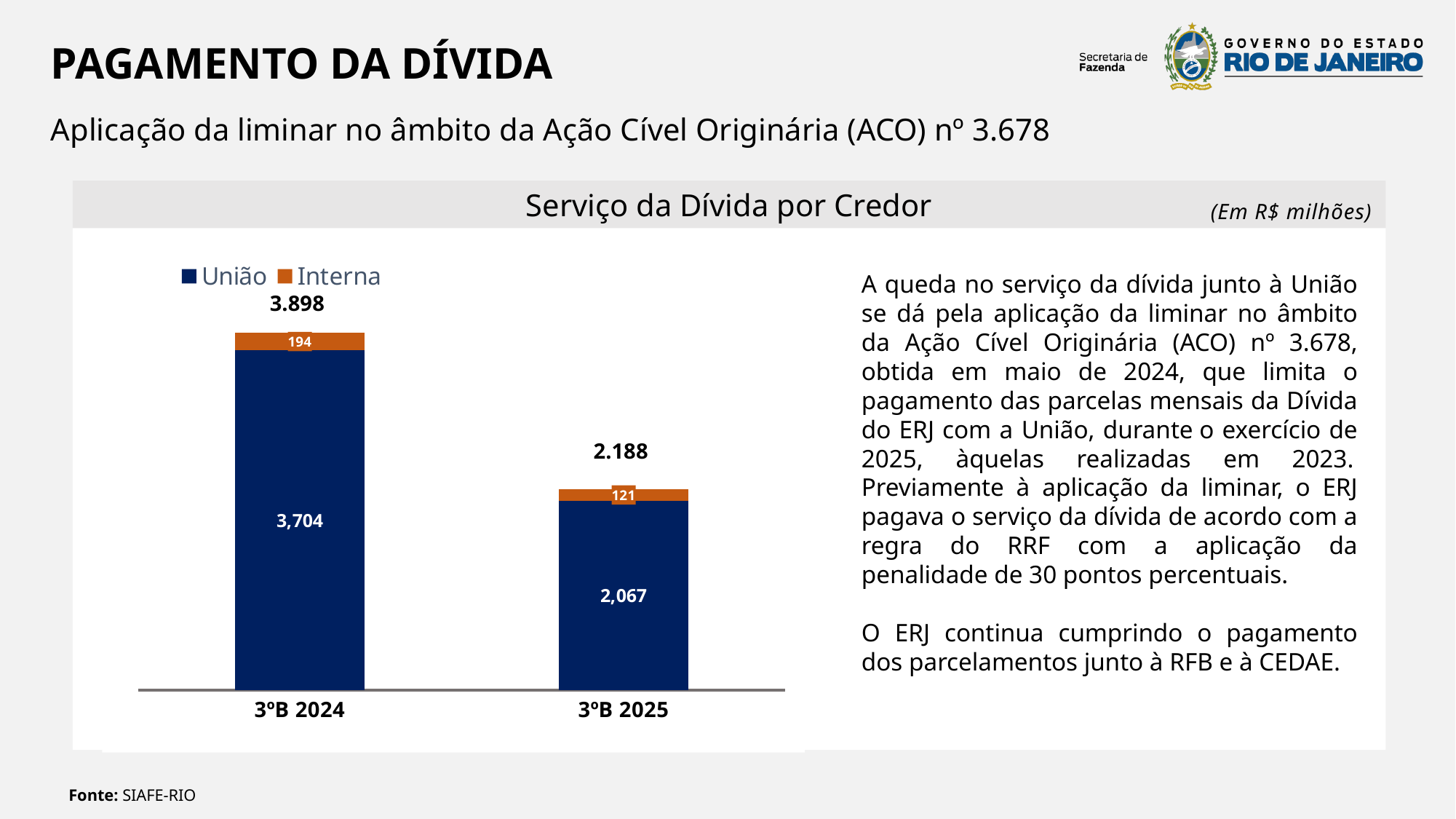
What is the value for Interna in 3ºB 2024? 194 What is the value for União in 3ºB 2024? 3,704 What is the total of the stacked bar for 3ºB 2025? 2.188 What is the difference between the Interna values for 3ºB 2024 and 3ºB 2025? 73 How many categories are shown on the x axis? 2 What kind of chart is shown? Stacked bar chart What is the difference between the União values for 3ºB 2024 and 3ºB 2025? 1,637 What is the value for Interna in 3ºB 2025? 121 Which period has the higher total debt service, 3ºB 2024 or 3ºB 2025? 3ºB 2024 What is the total of the stacked bar for 3ºB 2024? 3.898 How many series does the legend list? 2 What is the value for União in 3ºB 2025? 2,067